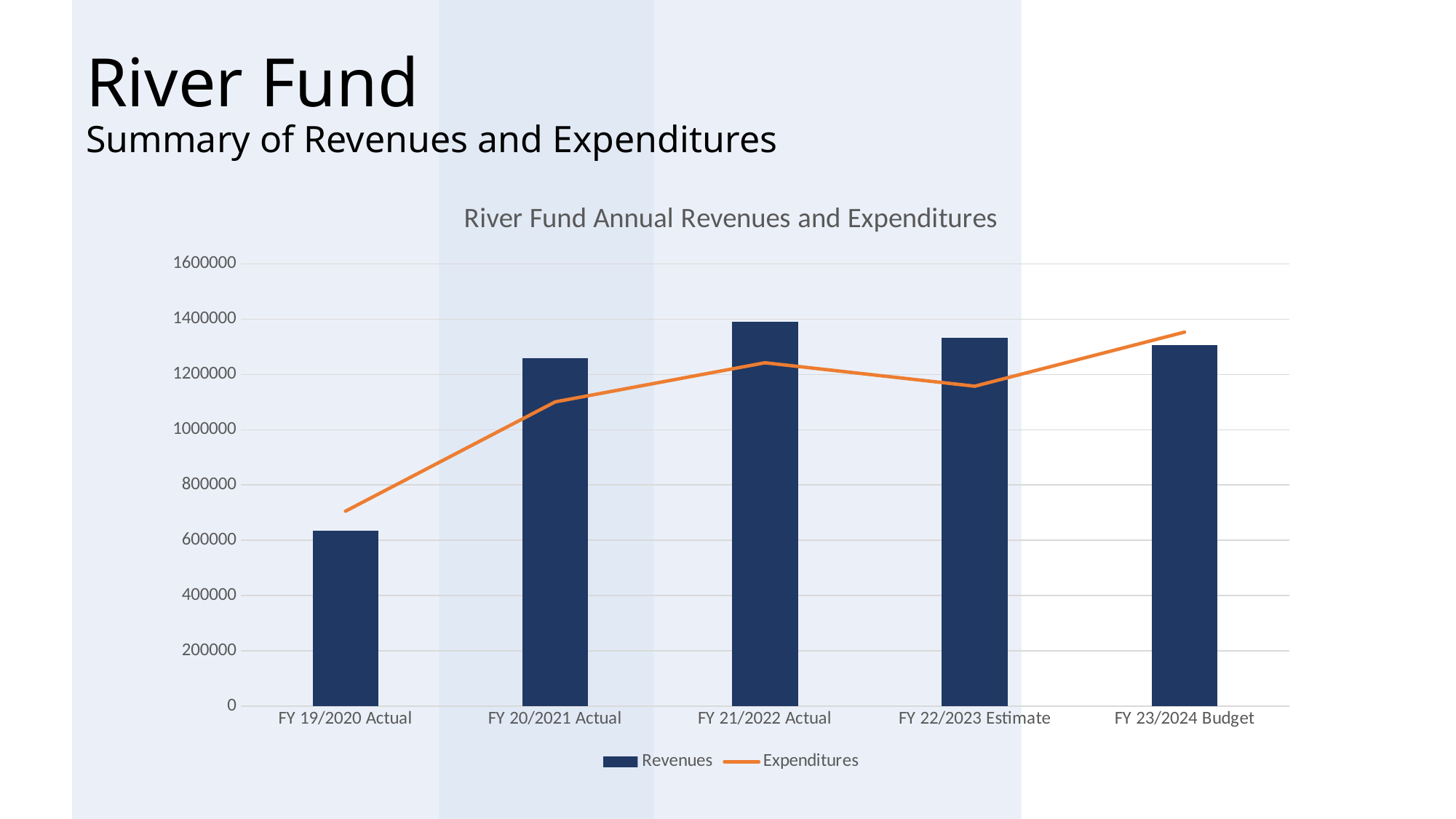
In which fiscal year is the Expenditures line at its lowest point? FY 19/2020 Actual Which fiscal year has the lowest Revenues bar? FY 19/2020 Actual Is the Revenues value for FY 21/2022 Actual greater or less than 1200000? greater How many series does the legend list? 2 What type of chart is shown on the slide? A combined bar and line chart How many fiscal year categories are shown on the x axis? 5 Is the Expenditures value for FY 20/2021 Actual greater or less than 1000000? greater Is the Revenues value for FY 19/2020 Actual greater or less than 800000? less Which fiscal year has the highest Revenues bar? FY 21/2022 Actual For FY 19/2020 Actual, which is larger: Revenues or Expenditures? Expenditures Which series is drawn as an orange line? Expenditures In which fiscal year is the Expenditures line at its highest point? FY 23/2024 Budget